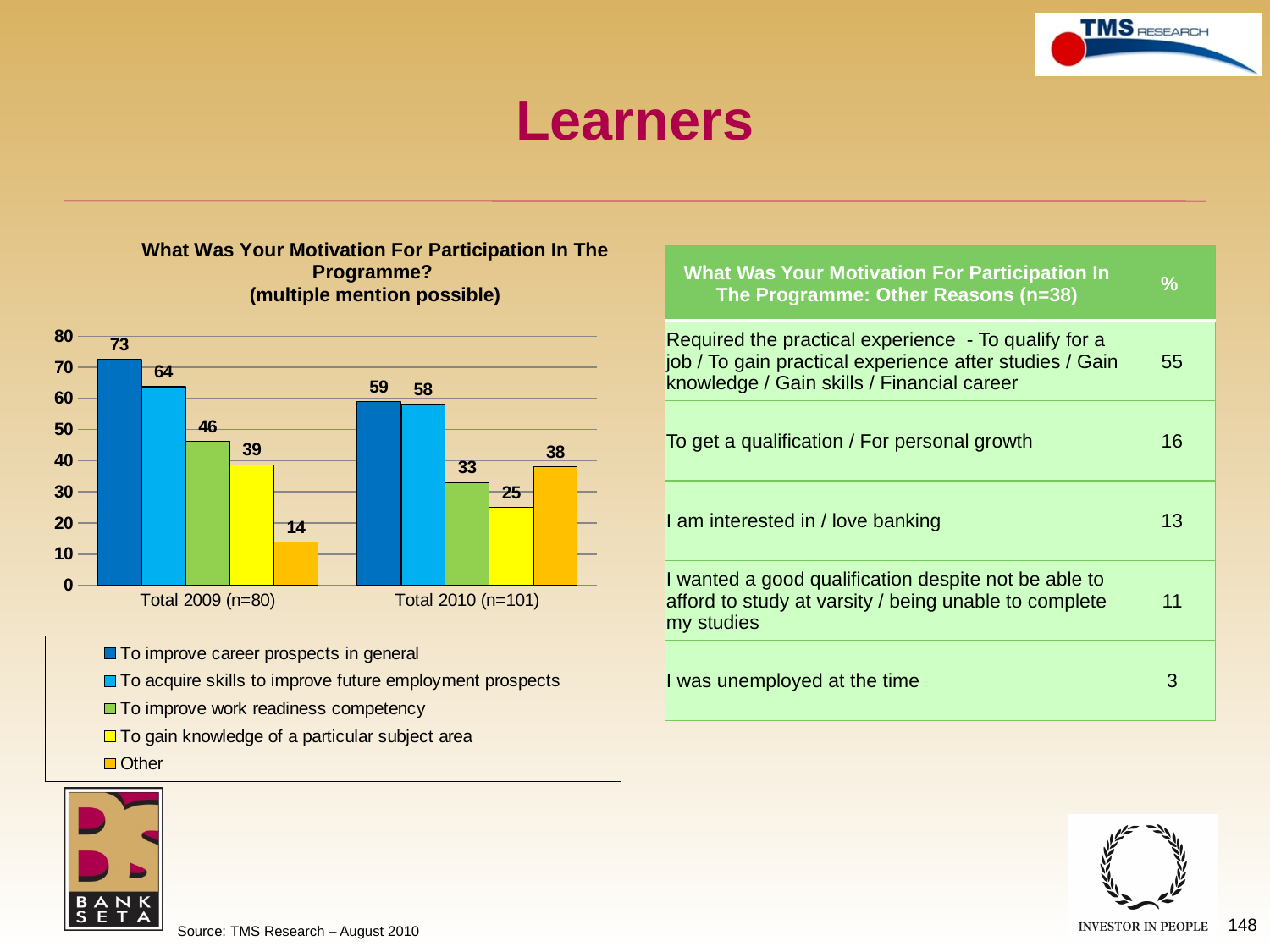
Which series has the highest value in Total 2009 (n=80)? To improve career prospects in general Which series has the lowest value in Total 2009 (n=80)? Other What is the difference between 'To improve work readiness competency' in Total 2009 (n=80) and Total 2010 (n=101)? 13 What is the value for 'Other' in Total 2010 (n=101)? 38 How many series does the legend list? 5 What kind of chart is shown on the slide? Bar chart Does the value for 'To improve career prospects in general' rise or fall from Total 2009 (n=80) to Total 2010 (n=101)? Fall How many categories are shown on the x axis? 2 What is the value for 'To improve career prospects in general' in Total 2009 (n=80)? 73 What colour represents 'To gain knowledge of a particular subject area' in the chart? Yellow Which is larger: 'Other' in Total 2009 (n=80) or 'Other' in Total 2010 (n=101)? Total 2010 (n=101) What is the value for 'To gain knowledge of a particular subject area' in Total 2010 (n=101)? 25